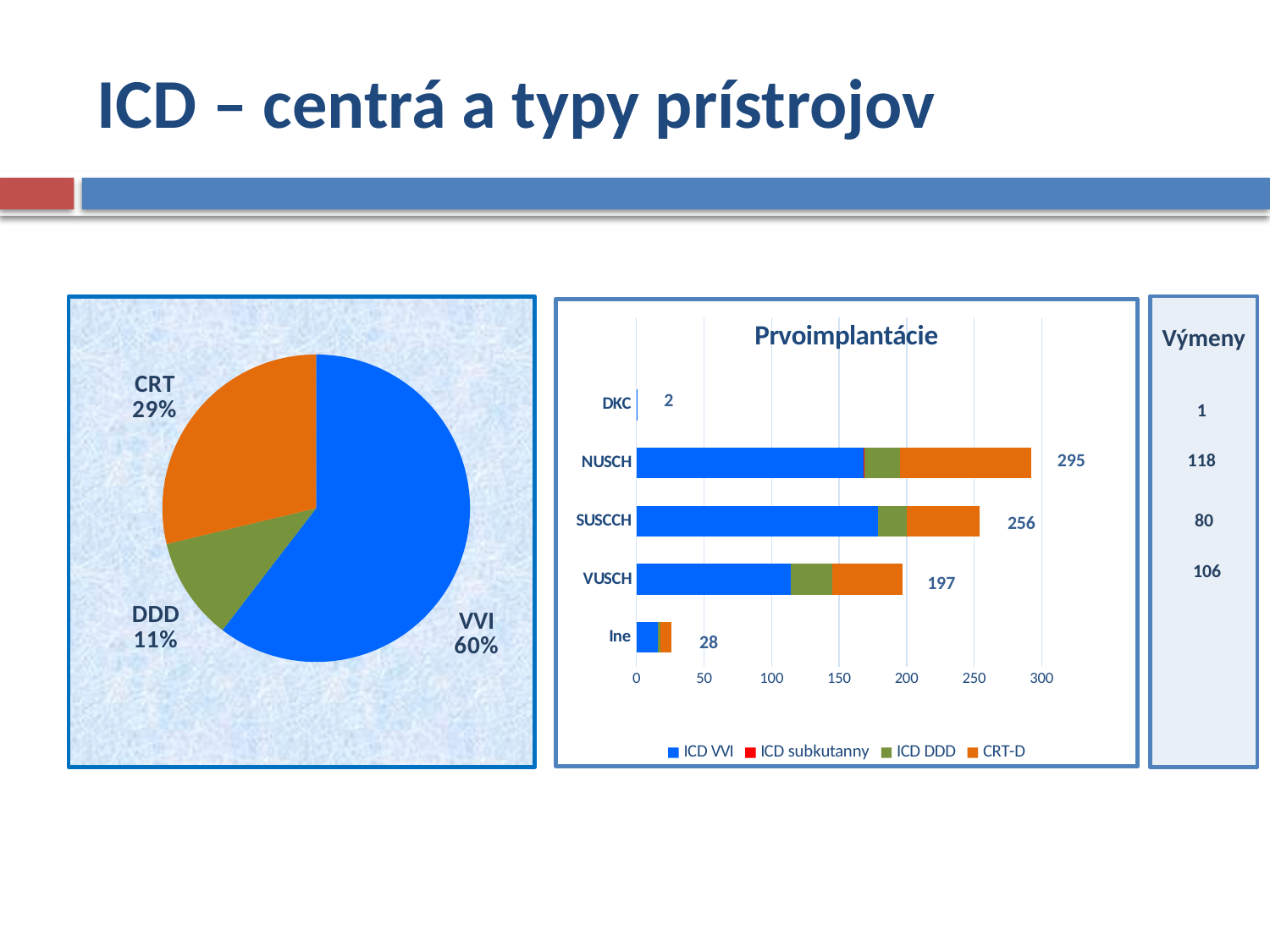
In the Prvoimplantácie chart, what is the total value for NUSCH? 295 In the pie chart on the left, what share does VVI have? 60% In the pie chart on the left, which category has the smallest share? DDD In the Prvoimplantácie chart, what is the total value for VUSCH? 197 How many slices does the pie chart on the left have? 3 In the pie chart on the left, which category has the largest share? VVI In the Prvoimplantácie chart, which centre has the highest total? NUSCH What kind of chart is the Prvoimplantácie chart? Stacked bar chart How many series does the legend of the Prvoimplantácie chart list? 4 In the pie chart on the left, what share does CRT have? 29% In the Prvoimplantácie chart, which centre has the lowest total? DKC In the Prvoimplantácie chart, what is the difference between the totals for NUSCH and SUSCCH? 39